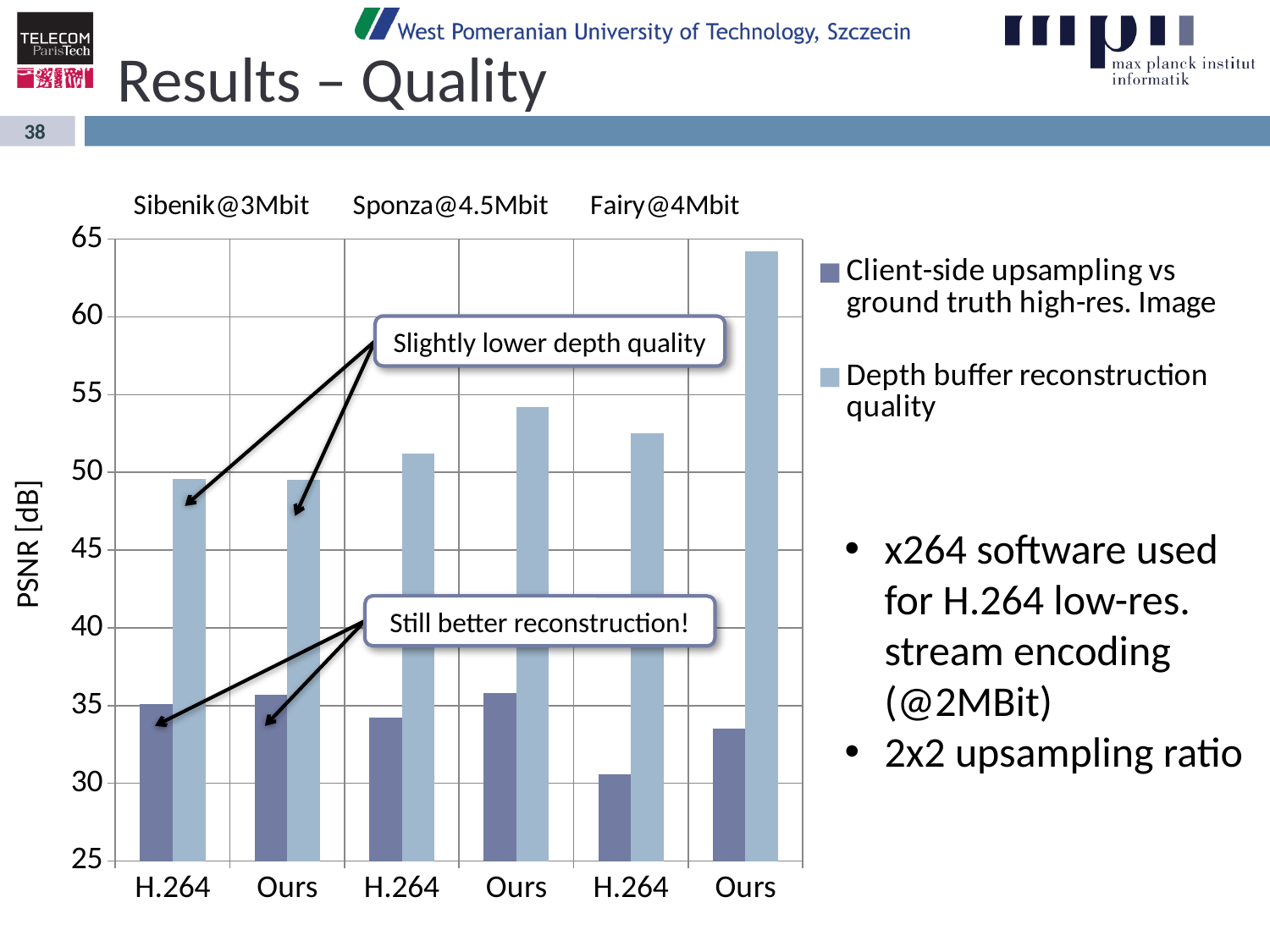
Which scene and method has the highest 'Depth buffer reconstruction quality' value? Fairy@4Mbit, Ours Which scene and method has the lowest 'Client-side upsampling vs ground truth high-res. Image' value? Fairy@4Mbit, H.264 How many bars are plotted for the 'Depth buffer reconstruction quality' series? 6 How many series does the legend list? 2 Is the 'Depth buffer reconstruction quality' value for Ours on Sponza@4.5Mbit greater or less than 50? greater What is the lowest value shown on the vertical axis? 25 For Fairy@4Mbit, which has the larger 'Client-side upsampling vs ground truth high-res. Image' value, H.264 or Ours? Ours Is the 'Depth buffer reconstruction quality' value for Ours on Fairy@4Mbit greater or less than 60? greater What is the label of the vertical axis? PSNR [dB] Is the 'Client-side upsampling vs ground truth high-res. Image' value for H.264 on Fairy@4Mbit greater or less than 35? less What kind of chart is shown on the slide? bar chart For Fairy@4Mbit, which has the larger 'Depth buffer reconstruction quality' value, H.264 or Ours? Ours